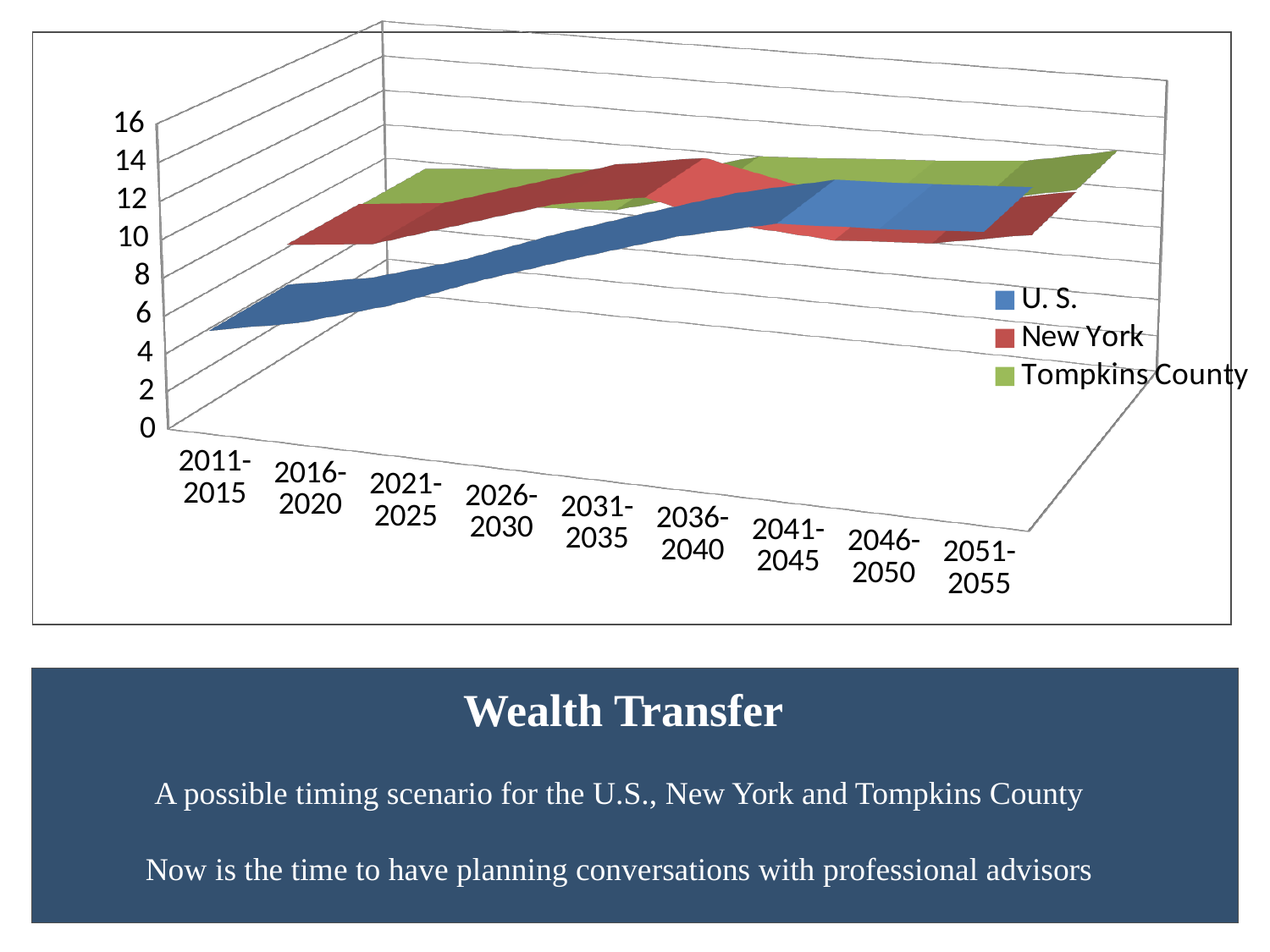
How many series does the chart's legend list? 3 Is the value for U. S. in 2011-2015 greater or less than 10? less What is the maximum value shown on the vertical axis of the chart? 16 Does the U. S. series rise or fall from 2011-2015 to 2041-2045? Rise What are the three series named in the chart's legend? U. S., New York, Tompkins County Which colour represents the U. S. series in the chart? Blue What is the first time period shown on the x axis? 2011-2015 What kind of chart is shown on the slide? 3D line chart What is the last time period shown on the x axis? 2051-2055 How many time periods are shown along the x axis of the chart? 9